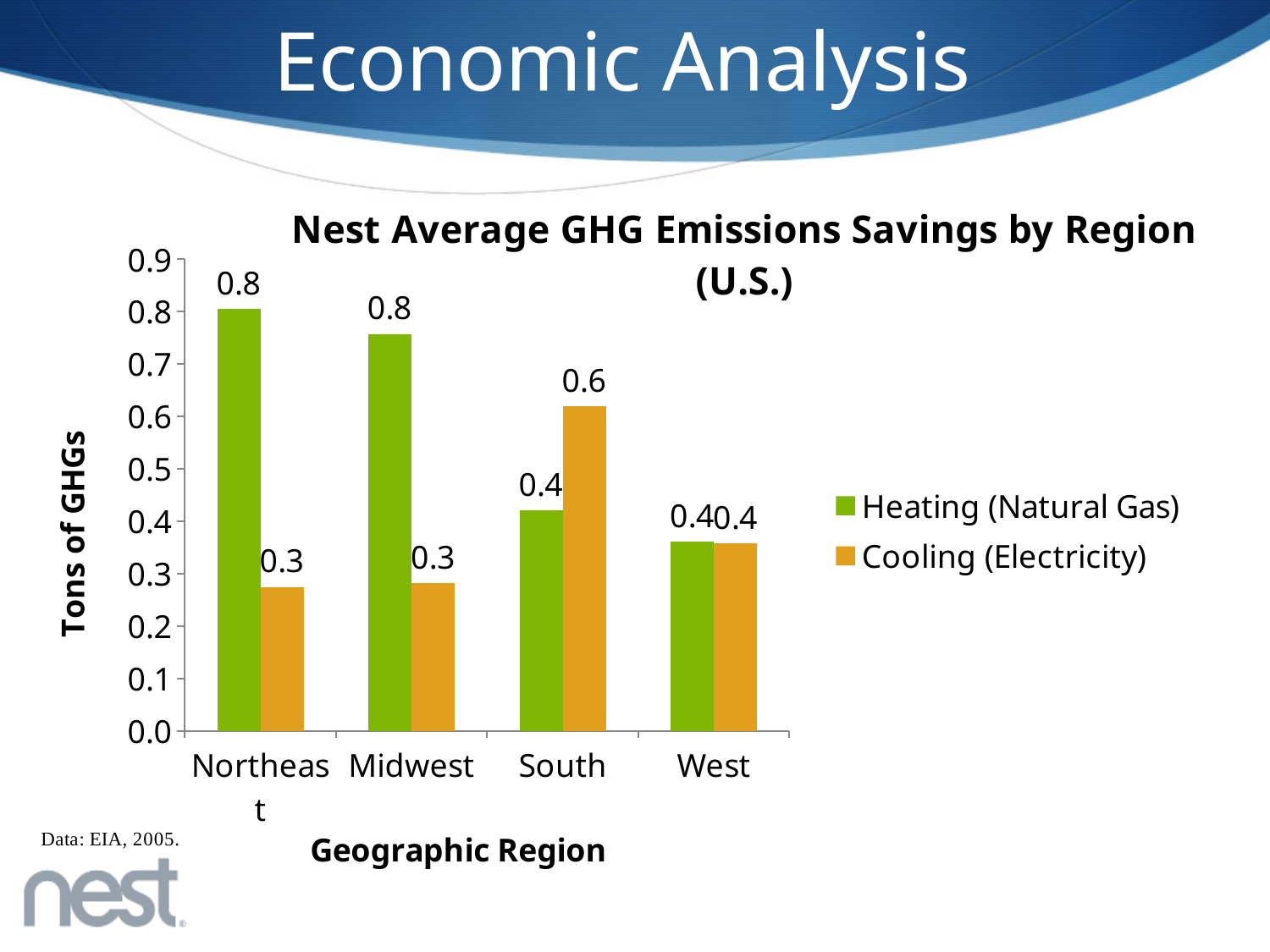
Is the Heating (Natural Gas) value for the West greater or less than 0.5? less In the Northeast, which is larger: Heating (Natural Gas) or Cooling (Electricity)? Heating (Natural Gas) What is the Cooling (Electricity) value for the South? 0.6 What is the Cooling (Electricity) value for the Midwest? 0.3 What is the difference between the Cooling (Electricity) and Heating (Natural Gas) values for the South? 0.2 What is the Heating (Natural Gas) value for the Northeast? 0.8 How many geographic regions are shown on the x axis? 4 How many series does the legend list? 2 Is the Heating (Natural Gas) value for the Midwest greater or less than 0.7? greater What kind of chart is shown on the slide? Bar chart What is the title of the y axis? Tons of GHGs Which region has the highest Cooling (Electricity) value? South